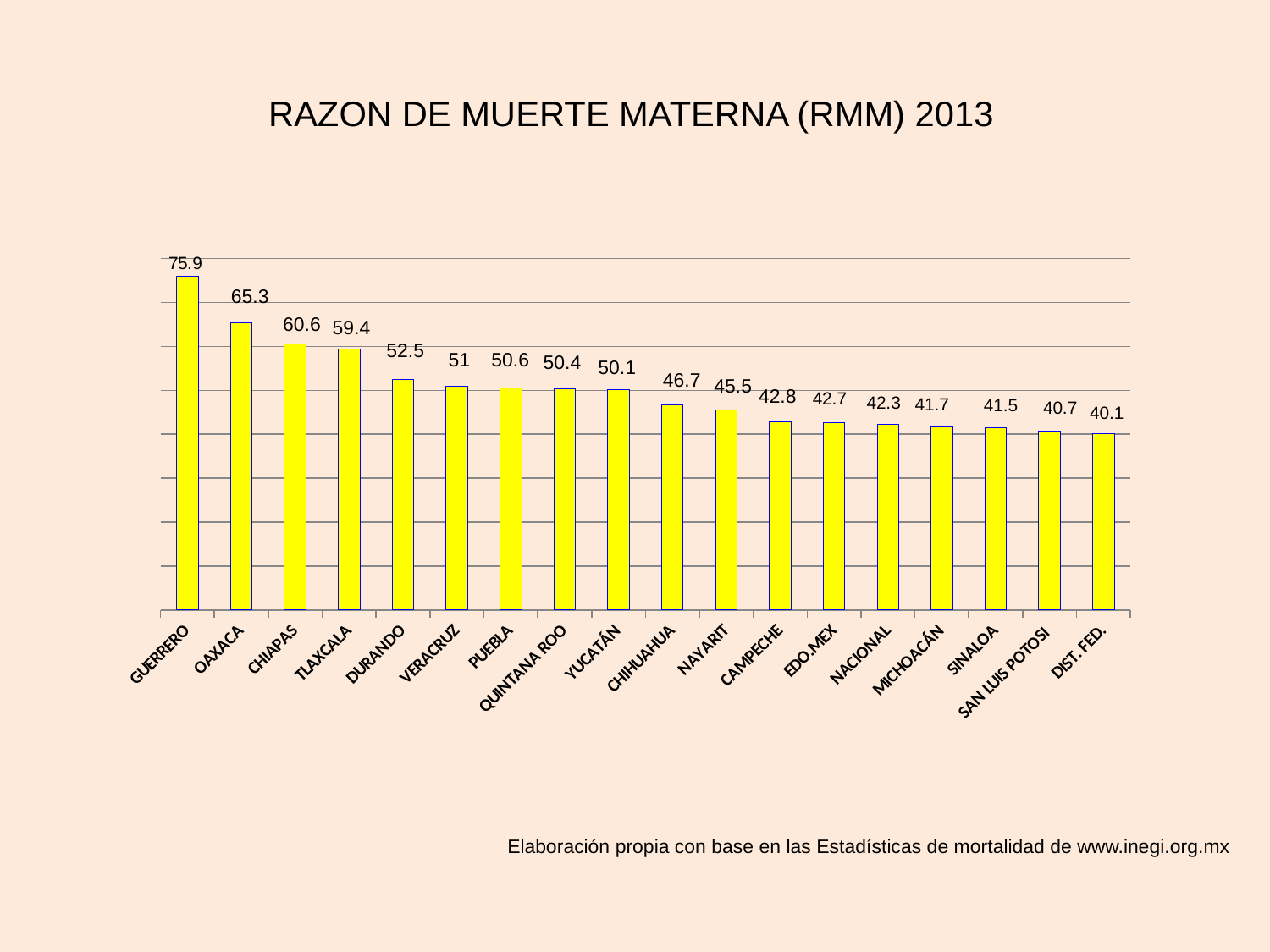
Which category has the highest value? GUERRERO Do the values rise or fall from left to right along the x axis? Fall What is the difference between the values for GUERRERO and OAXACA? 10.6 What is the value for NACIONAL? 42.3 What is the difference between the values for CHIAPAS and DIST. FED.? 20.5 What kind of chart is shown on the slide? Bar chart Which category has the lowest value? DIST. FED. How many categories are shown on the chart? 18 What is the value for QUINTANA ROO? 50.4 Which is larger, the value for CHIHUAHUA or the value for SINALOA? CHIHUAHUA What is the value for GUERRERO? 75.9